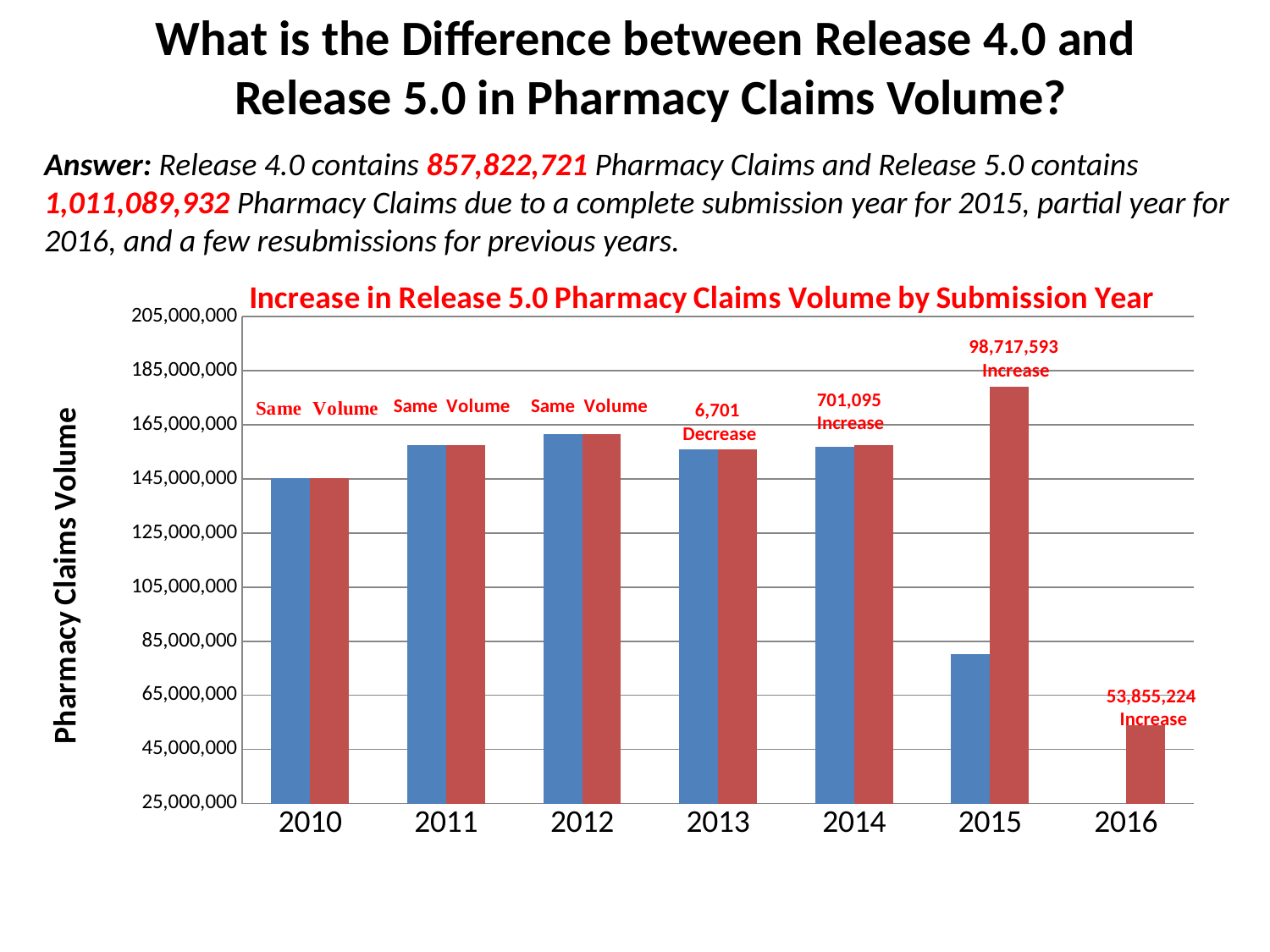
What is the title of the chart? Increase in Release 5.0 Pharmacy Claims Volume by Submission Year Is the red bar for 2016 greater or less than 65,000,000? less What is the label of the vertical axis of the chart? Pharmacy Claims Volume What increase is annotated for 2016 in the chart? 53,855,224 Increase What change is annotated for 2013 in the chart? 6,701 Decrease Which submission year has the tallest bar in the chart? 2015 Is the blue bar for 2015 greater or less than 85,000,000? less Which submission year has the shortest bar in the chart? 2016 How many submission years are shown on the x axis of the chart? 7 What type of chart is shown on the slide? bar chart What increase is annotated for 2015 in the chart? 98,717,593 Increase